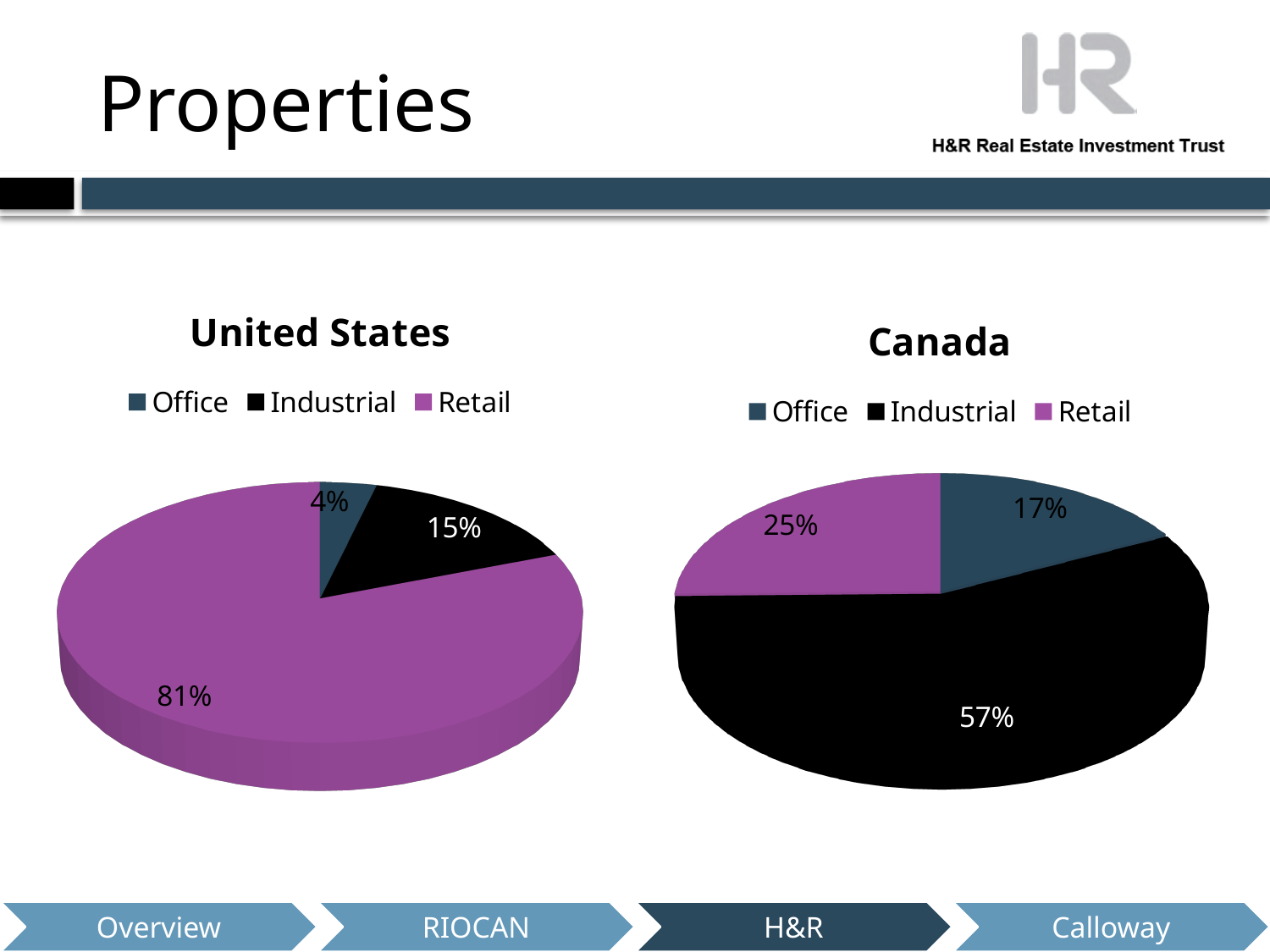
In the United States chart, what share of properties is Office? 4% In the Canada chart, which category has the largest share? Industrial In the United States chart, which colour represents Retail? Purple What kind of chart is the Canada chart? Pie chart In the United States chart, what is the difference between the Retail and Industrial shares? 66% In the Canada chart, what share of properties is Industrial? 57% In the United States chart, what share of properties is Retail? 81% In the Canada chart, which is larger, Office or Retail? Retail In the Canada chart, what is the difference between the Industrial and Office shares? 40% In the United States chart, which category has the smallest share? Office In the Canada chart, what share of properties is Retail? 25% How many categories does the United States chart show? 3